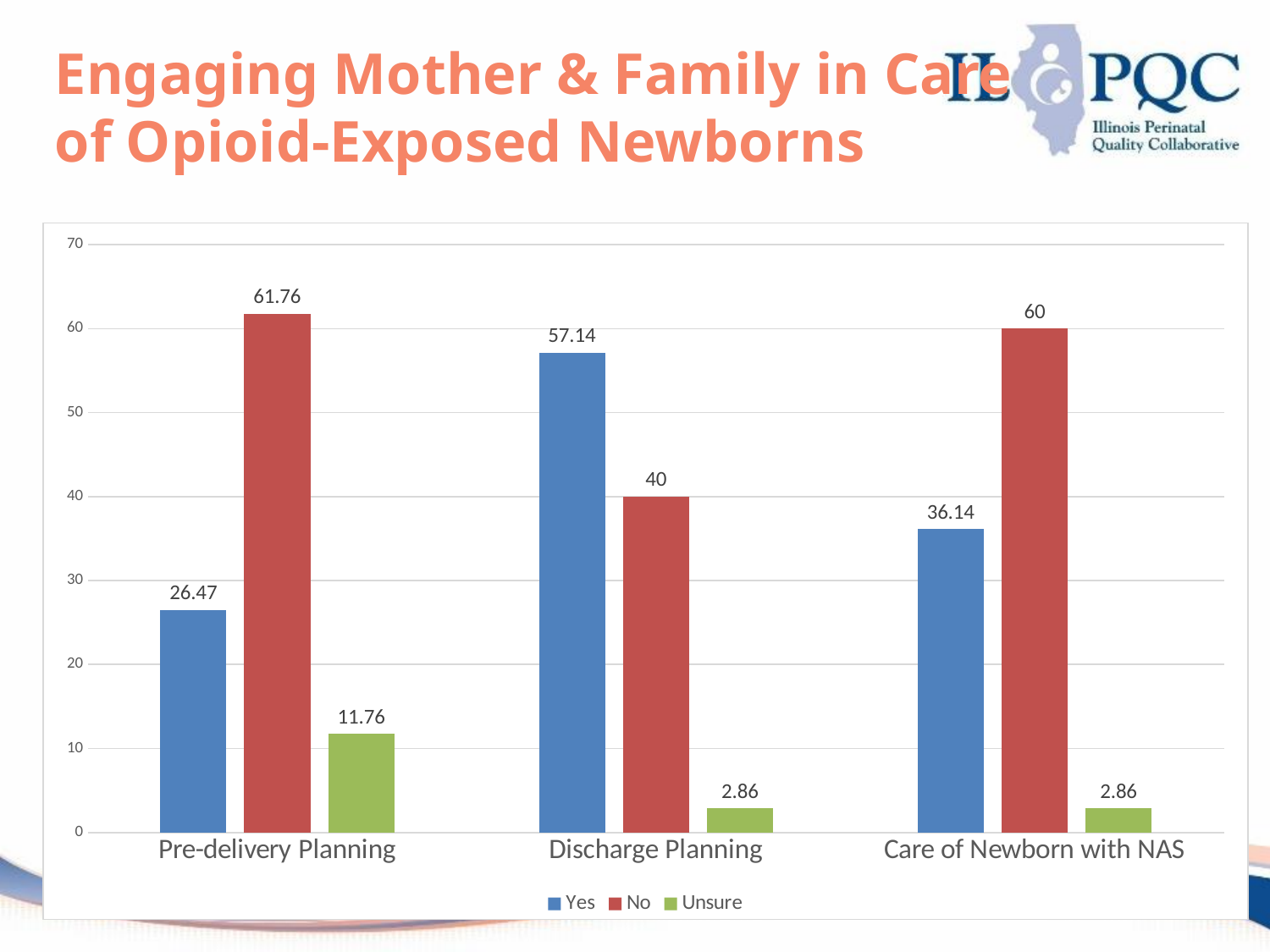
How many series does the legend list? 3 What is the difference between the "No" and "Yes" values for Pre-delivery Planning? 35.29 Is the "Yes" value for Care of Newborn with NAS greater or less than 40? less What kind of chart is shown on the slide? Bar chart How many categories are shown on the x axis? 3 What is the value for "Yes" in the Discharge Planning category? 57.14 Which is larger for Care of Newborn with NAS: the "Yes" value or the "No" value? No Which category has the lowest "No" value? Discharge Planning What colour represents the "Unsure" series in the legend? Green What is the value for "No" in the Pre-delivery Planning category? 61.76 Which category has the highest "Yes" value? Discharge Planning What is the value for "Unsure" in the Care of Newborn with NAS category? 2.86